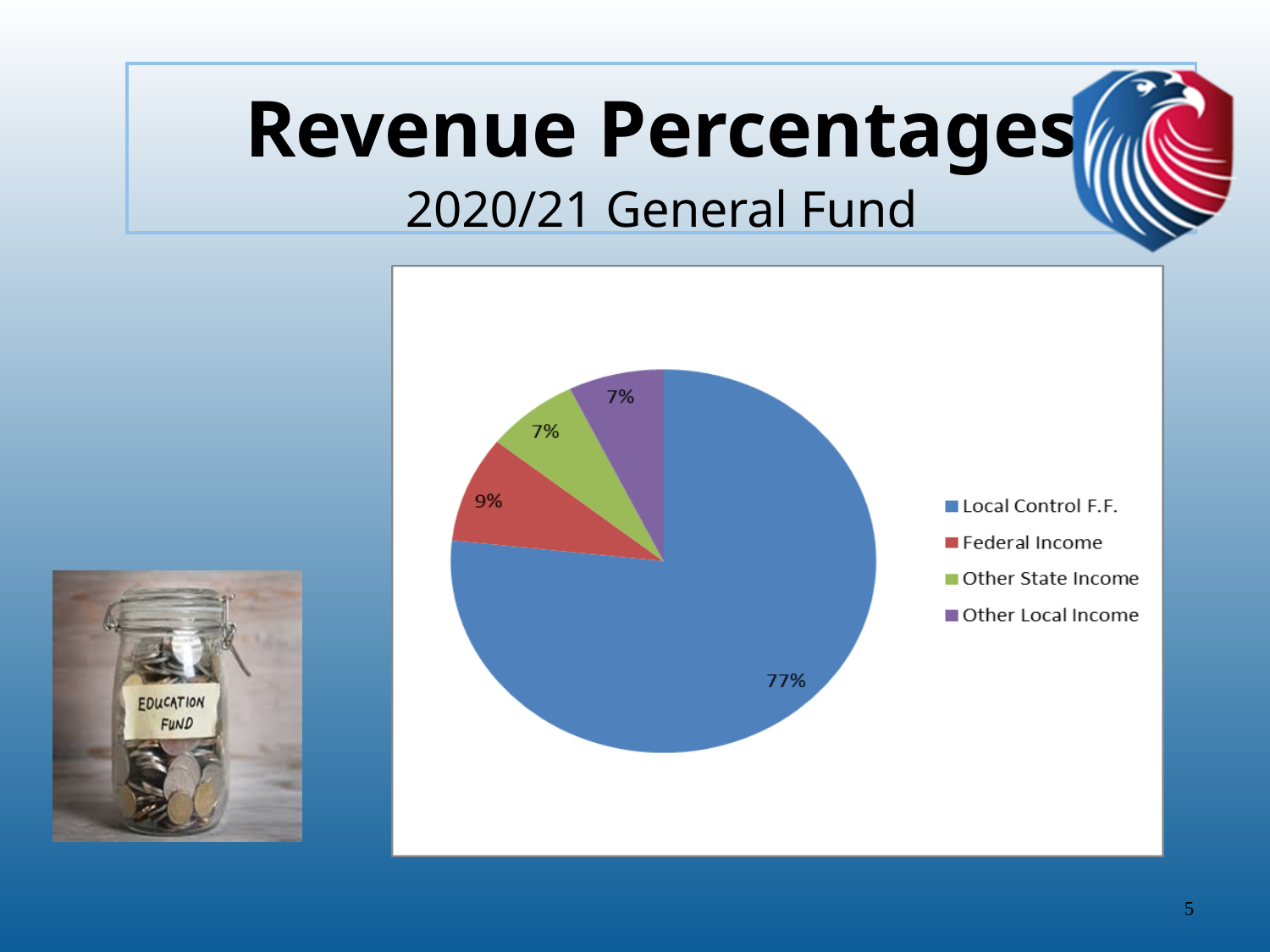
What fiscal year does the chart's subtitle refer to? 2020/21 What kind of chart is shown on the slide? Pie chart What is the difference in percentage points between Local Control F.F. and Federal Income? 68 Which category has the largest share of the pie? Local Control F.F. What percentage of the pie is Local Control F.F.? 77% What colour is the Federal Income slice? Red What percentage of the pie is Federal Income? 9% Which is larger, Federal Income or Other State Income? Federal Income How many categories does the legend list? 4 What percentage of the pie is Other State Income? 7% What percentage of the pie is Other Local Income? 7% What is the combined share of Federal Income, Other State Income and Other Local Income? 23%